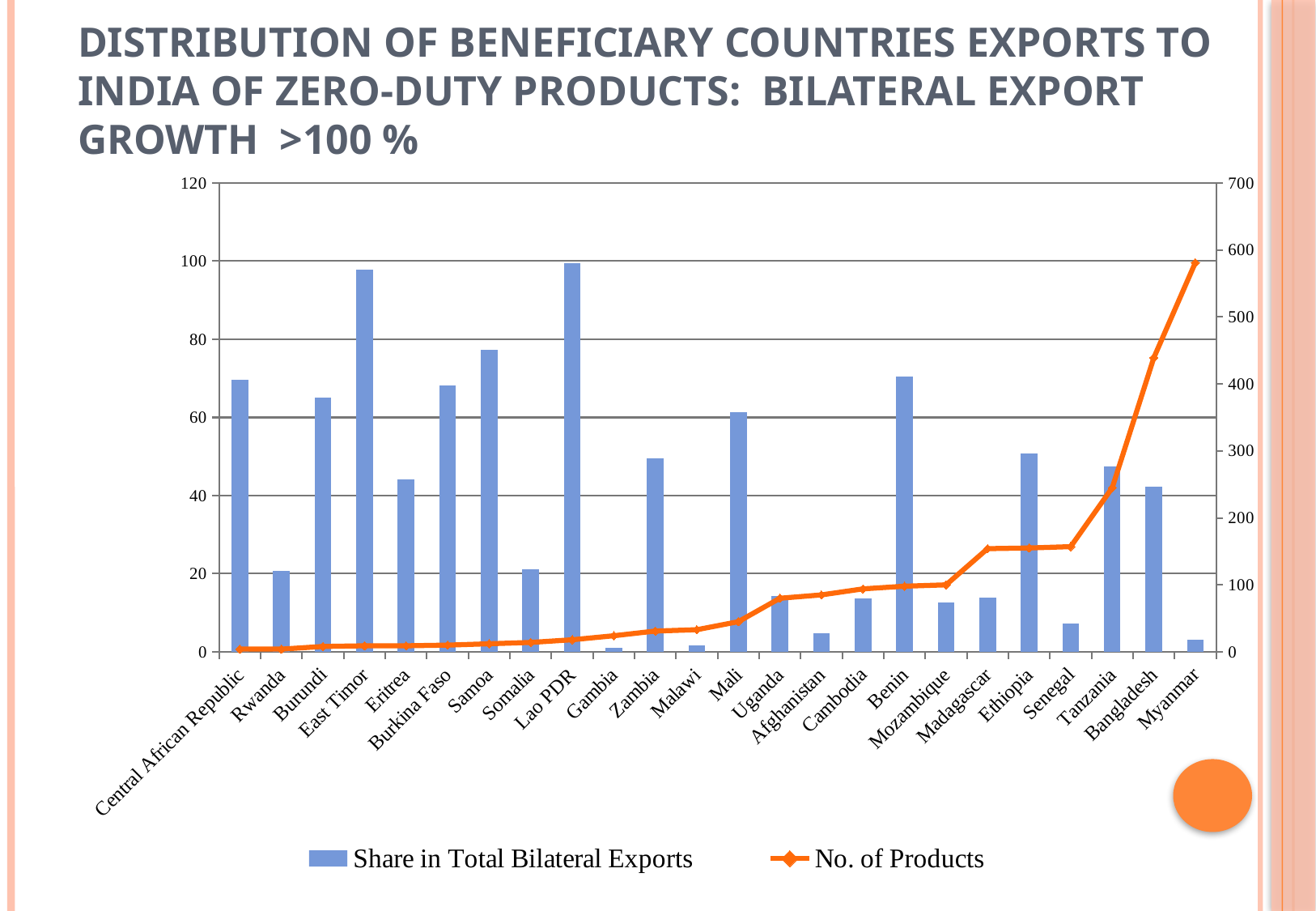
Does the No. of Products line generally rise or fall from left to right along the x axis? Rise How many countries are shown on the x axis? 24 Is the Share in Total Bilateral Exports for Samoa greater or less than 80? less Is the Share in Total Bilateral Exports for Central African Republic greater or less than 60? greater Which country has the highest value for No. of Products? Myanmar Which has a larger Share in Total Bilateral Exports, Samoa or Somalia? Samoa Is the No. of Products for Myanmar greater or less than 500? greater How many series does the legend list? 2 Which has a larger Share in Total Bilateral Exports, Benin or Mozambique? Benin Which series is plotted as an orange line? No. of Products What kind of chart is shown on the slide? A combination bar and line chart